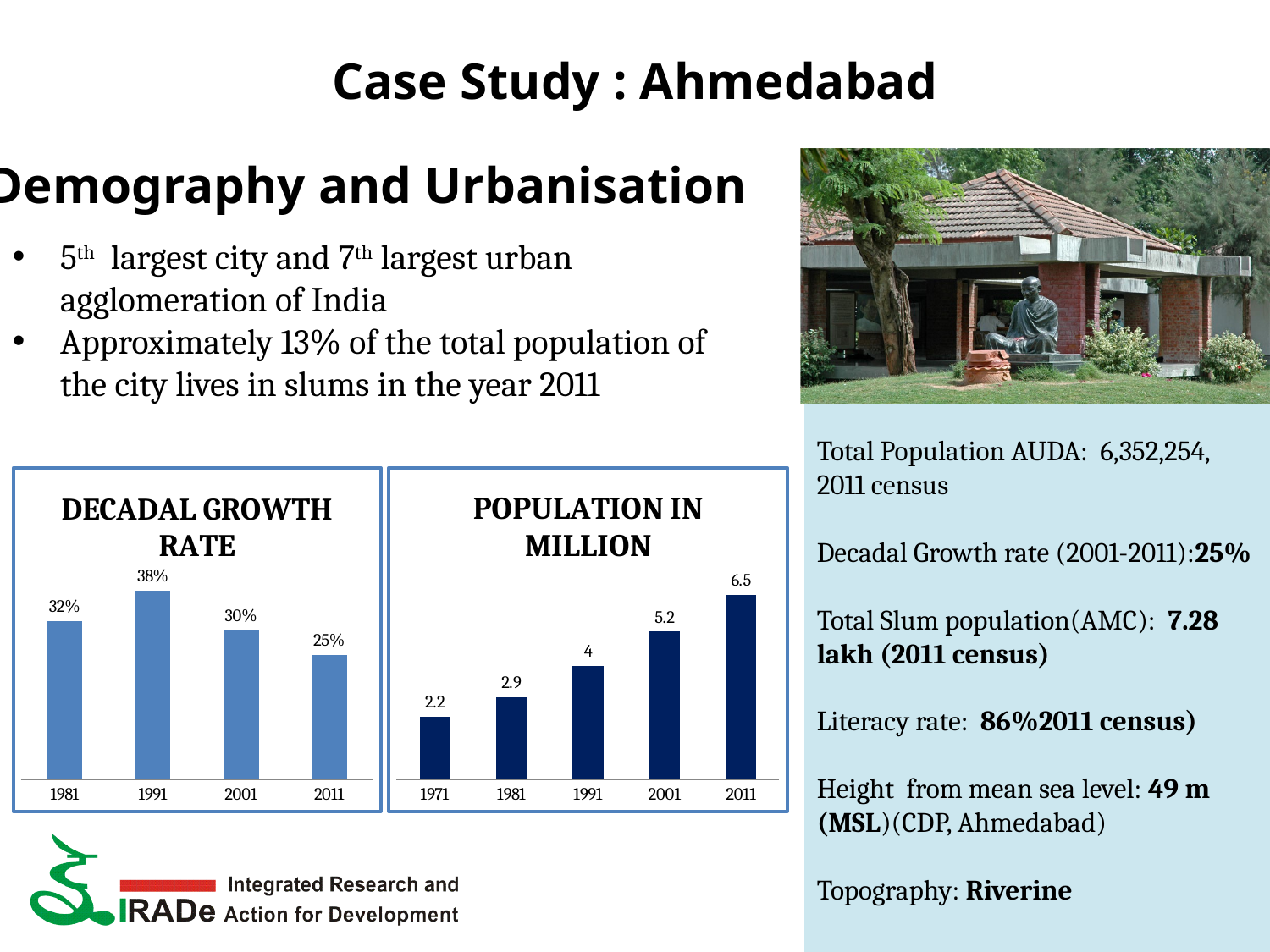
In the POPULATION IN MILLION chart, what is the value for 2001? 5.2 In the DECADAL GROWTH RATE chart, what is the difference between the values for 1991 and 2011? 13% In the POPULATION IN MILLION chart, do the values rise or fall from 1971 to 2011? rise In the DECADAL GROWTH RATE chart, which year has the highest growth rate? 1991 In the DECADAL GROWTH RATE chart, what is the value for 1991? 38% In the DECADAL GROWTH RATE chart, how many years are shown? 4 In the POPULATION IN MILLION chart, which year has the highest population? 2011 In the DECADAL GROWTH RATE chart, which year has the lowest growth rate? 2011 In the POPULATION IN MILLION chart, what is the value for 1971? 2.2 In the POPULATION IN MILLION chart, what is the difference between the values for 2011 and 1991? 2.5 In the POPULATION IN MILLION chart, how many years are shown? 5 What kind of chart is the POPULATION IN MILLION chart? bar chart